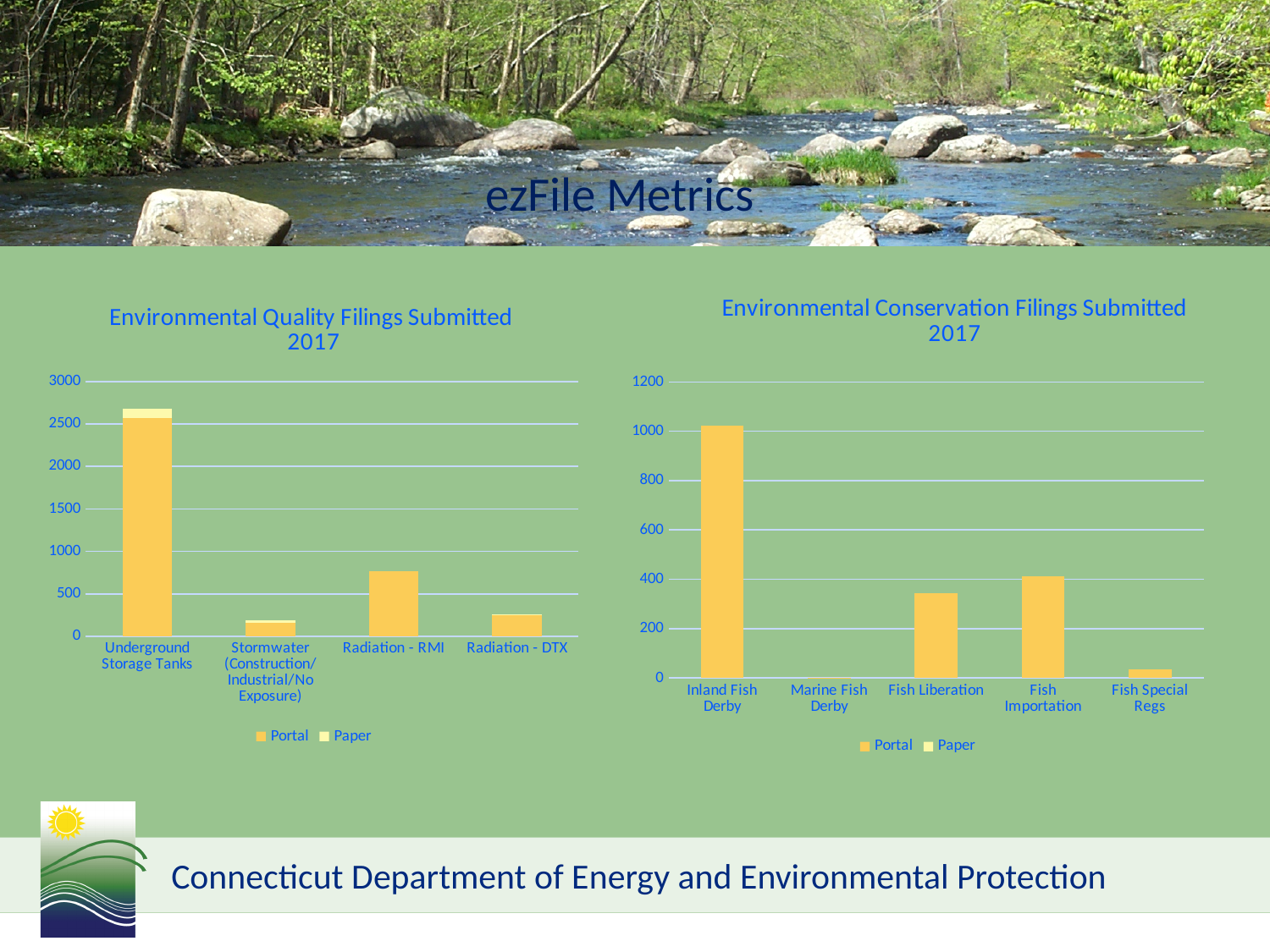
What type of chart is the 'Environmental Quality Filings Submitted 2017' chart? bar chart In the 'Environmental Quality Filings Submitted 2017' chart, which category has the lowest total? Stormwater (Construction/Industrial/No Exposure) In the 'Environmental Quality Filings Submitted 2017' chart, how many categories are shown on the x axis? 4 In the 'Environmental Quality Filings Submitted 2017' chart, is the total for Underground Storage Tanks greater or less than 2500? greater In the 'Environmental Quality Filings Submitted 2017' chart, which category has the highest total? Underground Storage Tanks In the 'Environmental Conservation Filings Submitted 2017' chart, is the value for Inland Fish Derby greater or less than 1000? greater In the 'Environmental Quality Filings Submitted 2017' chart, which is larger, Radiation - RMI or Radiation - DTX? Radiation - RMI In the 'Environmental Quality Filings Submitted 2017' chart, how many series does the legend list? 2 In the 'Environmental Conservation Filings Submitted 2017' chart, what are the two series listed in the legend? Portal and Paper In the 'Environmental Conservation Filings Submitted 2017' chart, how many categories are shown on the x axis? 5 In the 'Environmental Conservation Filings Submitted 2017' chart, which category has the highest value? Inland Fish Derby In the 'Environmental Quality Filings Submitted 2017' chart, is the value for Radiation - RMI greater or less than 1000? less